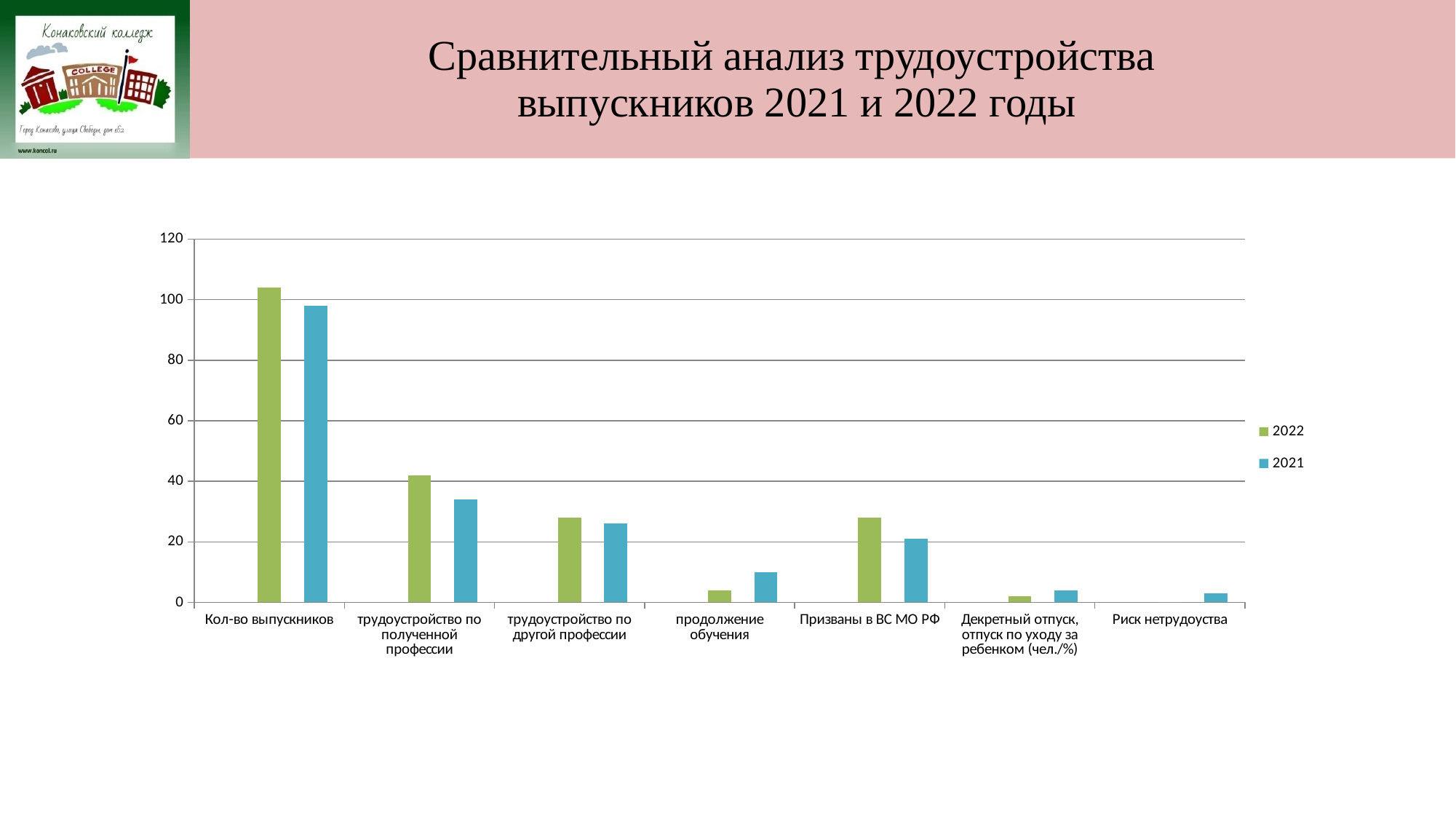
For Призваны в ВС МО РФ, which series has the larger value, 2022 or 2021? 2022 Is the 2022 value for трудоустройство по полученной профессии greater or less than 40? greater For продолжение обучения, which series has the larger value, 2022 or 2021? 2021 Which category has the highest value for the 2021 series? Кол-во выпускников How many categories are shown on the x axis of the chart? 7 How many series does the chart legend list? 2 Is the 2022 value for Кол-во выпускников greater or less than 80? greater Is the 2021 value for трудоустройство по полученной профессии greater or less than 40? less What kind of chart is shown on the slide? bar chart For трудоустройство по полученной профессии, which series has the larger value, 2022 or 2021? 2022 Which series are listed in the chart legend? 2022 and 2021 Which category has the highest value for the 2022 series? Кол-во выпускников